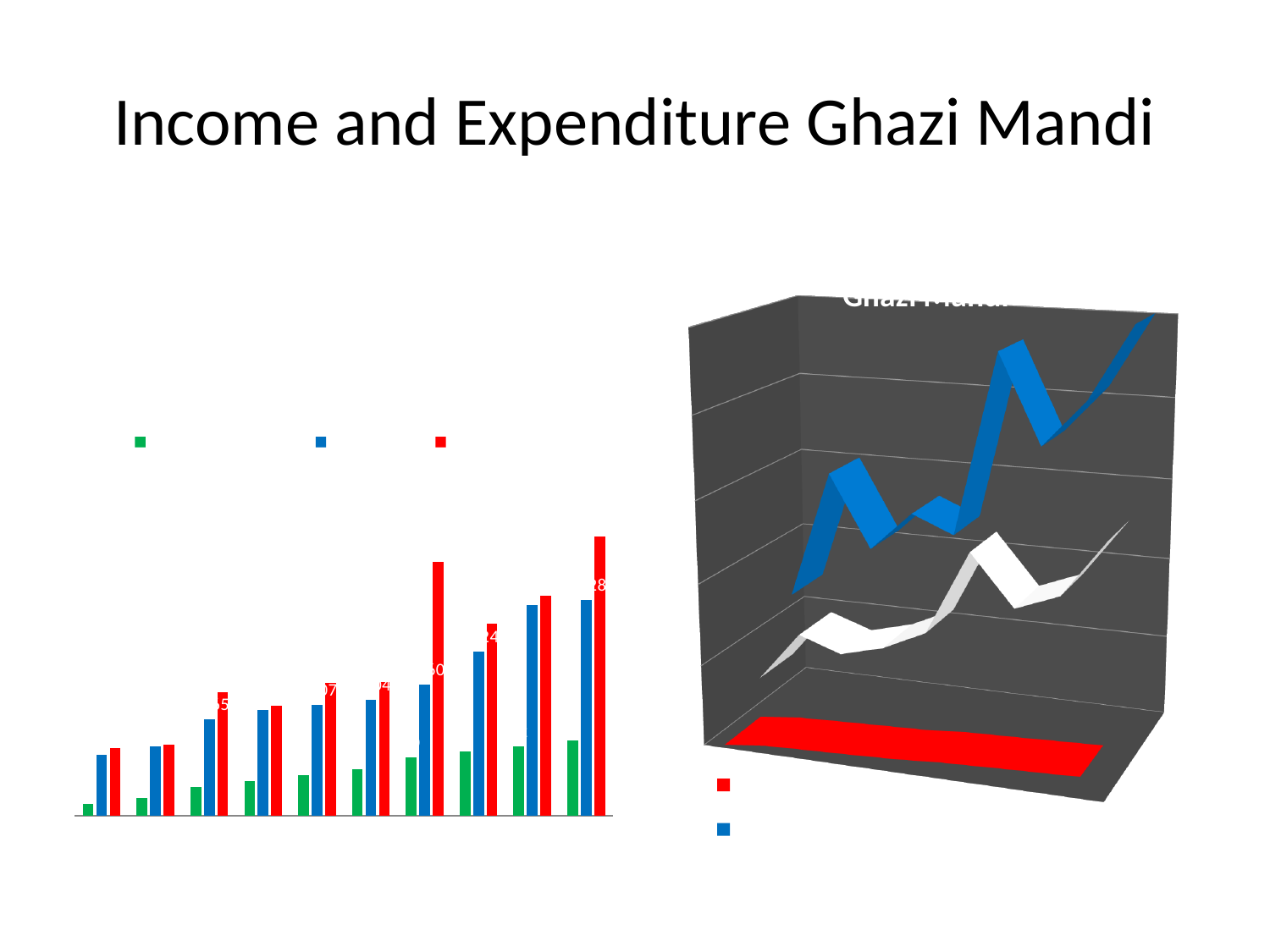
What colours are the three series in the bar chart on the left? green, blue and red In the bar chart on the left, in the rightmost group, is the red bar or the blue bar taller? red What kind of chart is the chart on the right of the slide? 3D line chart In the bar chart on the left, which group has the tallest red bar? the rightmost (last) group In the bar chart on the left, which group has the shortest green bar? the leftmost (first) group How many series does the legend of the bar chart on the left list? 3 What kind of chart is the chart on the left of the slide? bar chart In the bar chart on the left, do the green bars generally rise or fall from left to right? rise How many groups of bars (categories) does the bar chart on the left show? 10 In the bar chart on the left, which colour of bar is the shortest in every group? green In the bar chart on the left, do the blue bars generally rise or fall from left to right? rise